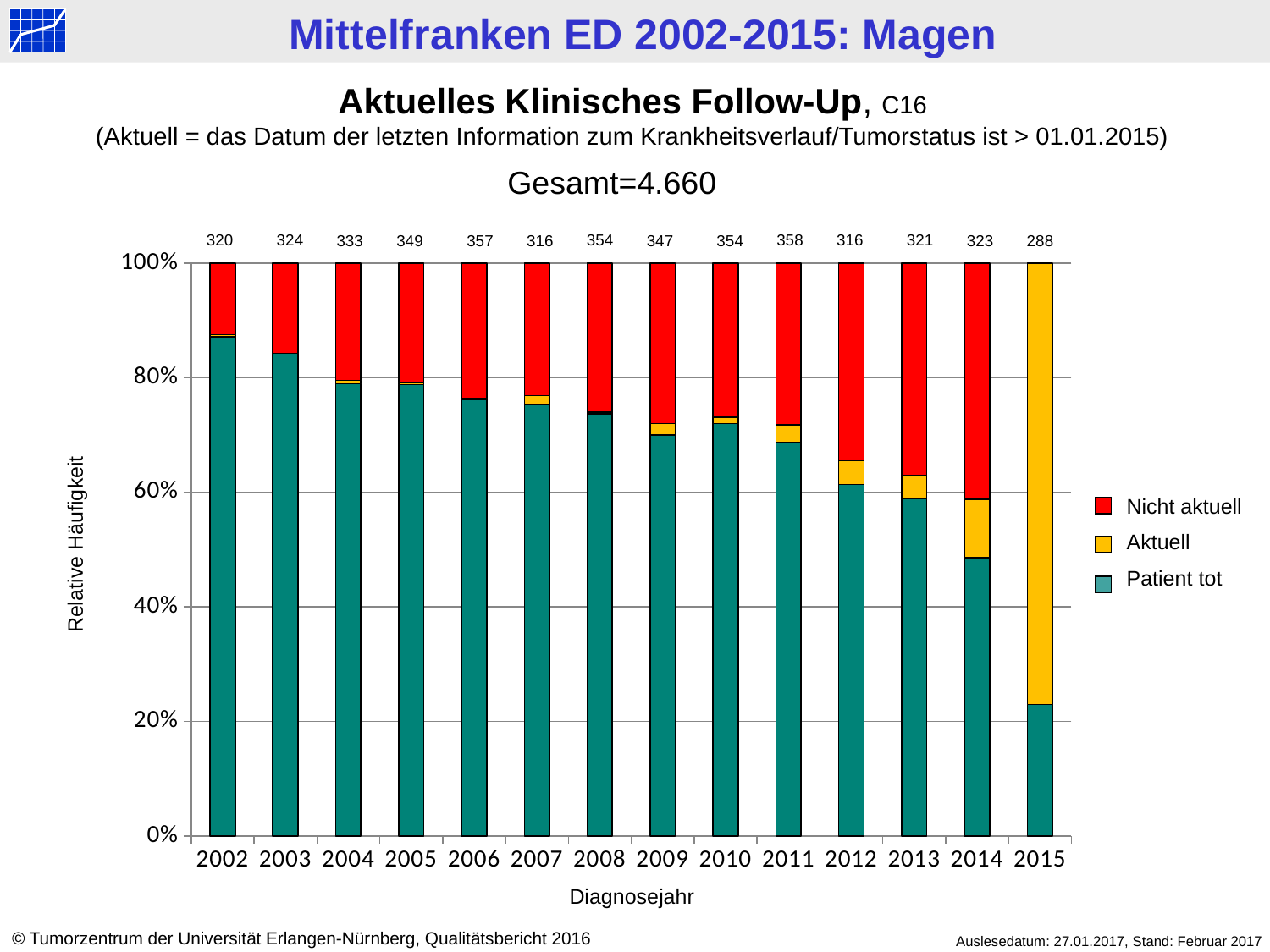
How many diagnosis years (Diagnosejahr) are shown on the x axis? 14 Which year has the lowest number printed above its bar? 2015 Which year has the highest number printed above its bar? 2011 What is the number printed above the bar for 2002? 320 What is the number printed above the bar for 2011? 358 What kind of chart is shown on the slide? stacked bar chart What is the number printed above the bar for 2015? 288 What is the difference between the numbers printed above the bars for 2006 and 2015? 69 How many series does the legend list? 3 Is the 'Patient tot' share for 2015 greater or less than 40%? less Is the 'Patient tot' share for 2002 greater or less than 80%? greater Does the 'Patient tot' share rise or fall from 2002 to 2015? fall